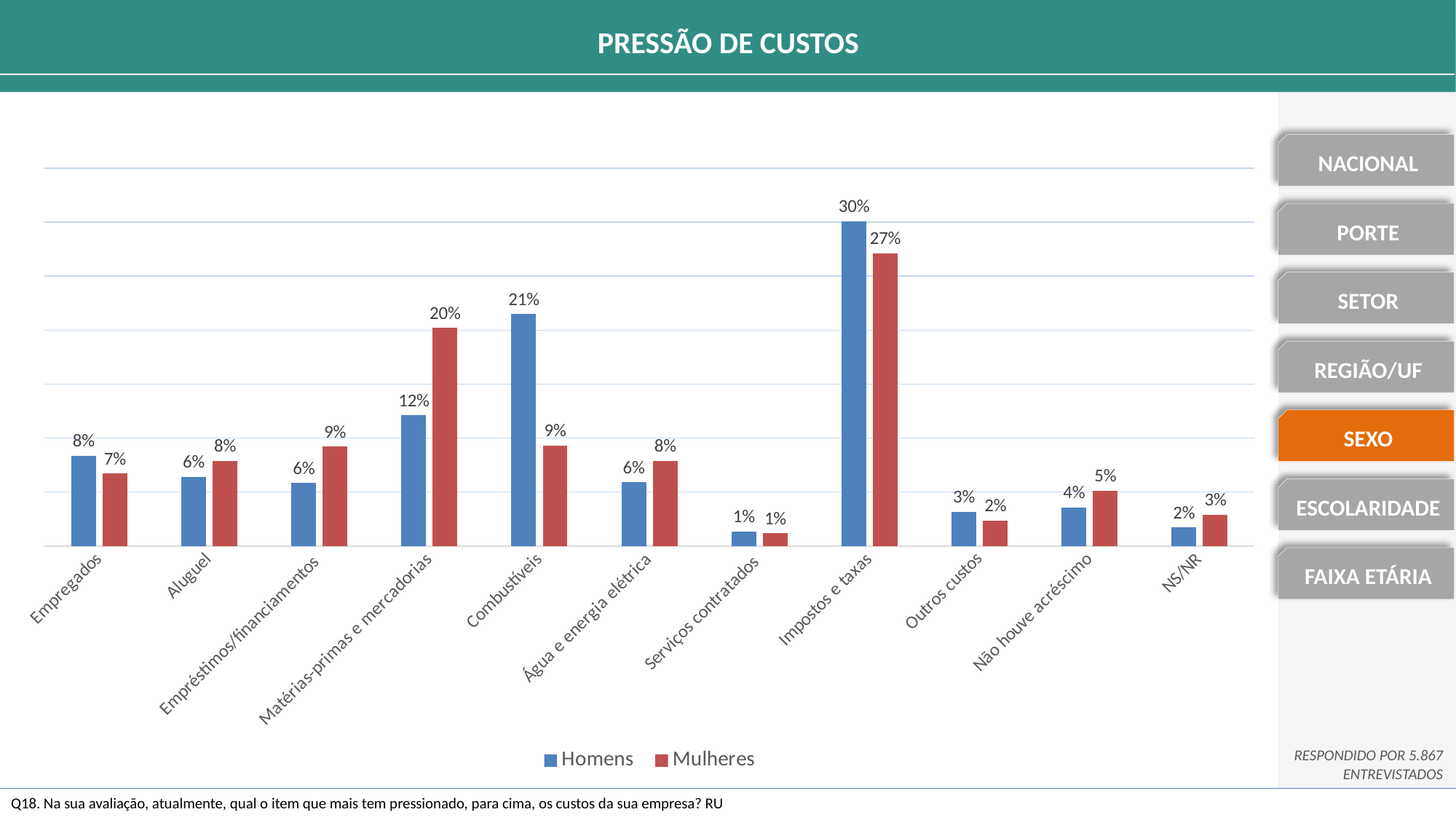
What is the difference between Homens and Mulheres in the Combustíveis category? 12% What is the value for Homens in the Impostos e taxas category? 30% What colour represents the Mulheres series? Red What is the value for Mulheres in the Matérias-primas e mercadorias category? 20% Which category has the lowest value for Homens? Serviços contratados What is the value for Homens in the Combustíveis category? 21% How many series does the legend list? 2 In the Água e energia elétrica category, which is larger, Homens or Mulheres? Mulheres What kind of chart is shown on the slide? Bar chart How many categories are shown on the x axis? 11 What is the difference between Mulheres and Homens in the Matérias-primas e mercadorias category? 8% Which category has the highest value for Mulheres? Impostos e taxas